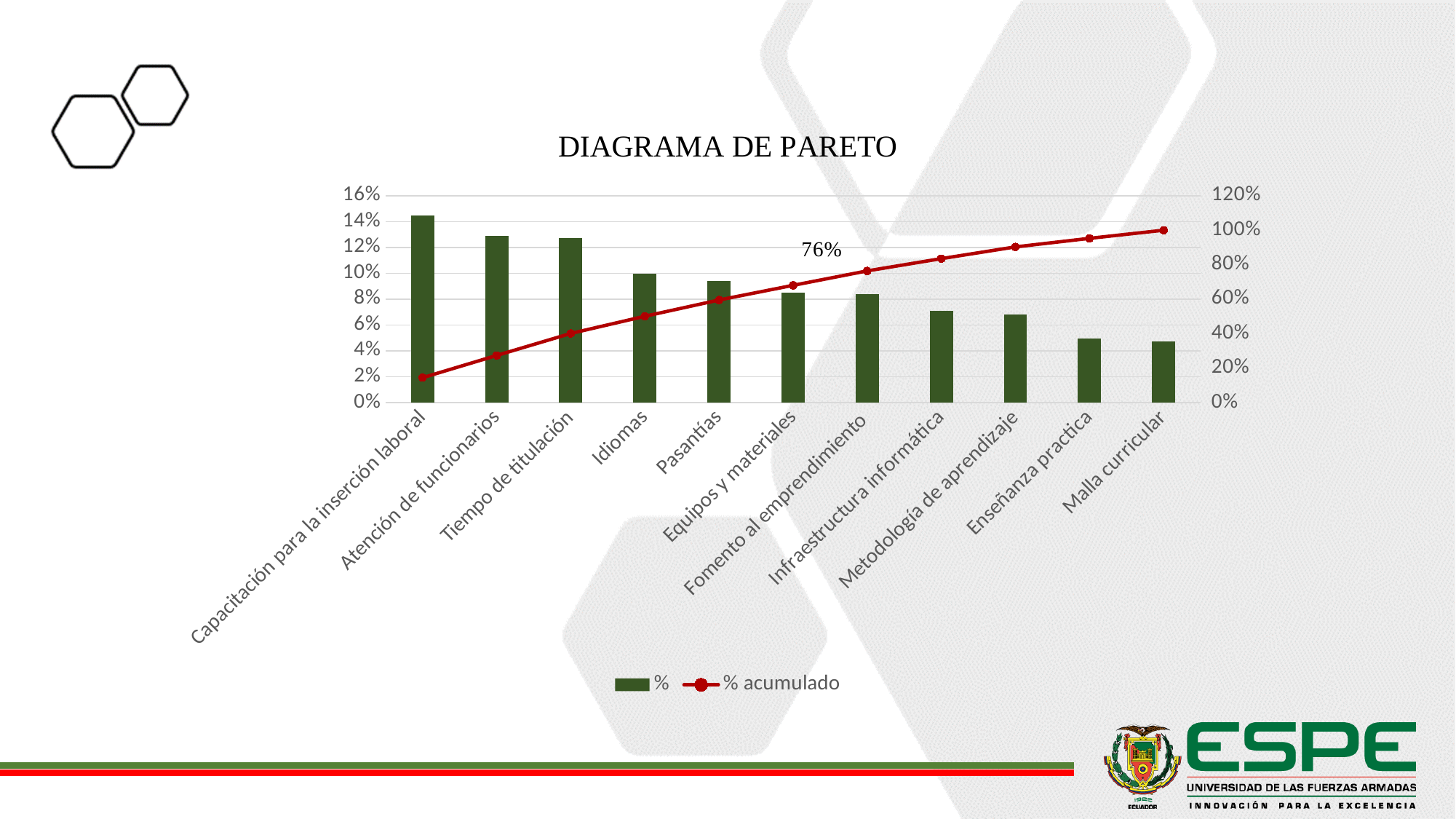
How many series does the legend list? 2 How many categories are shown on the x axis? 11 Is the bar value for Capacitación para la inserción laboral greater or less than 12%? greater What are the two series named in the legend? % and % acumulado Is the bar value for Idiomas greater or less than 8%? greater Do the bar values rise or fall from left to right along the x axis? fall What value is printed as a data label on the % acumulado line? 76% Is the bar value for Malla curricular greater or less than 6%? less Does the % acumulado line rise or fall from left to right? rise Which category has the highest bar? Capacitación para la inserción laboral What is the title of the chart? DIAGRAMA DE PARETO Which has the larger bar, Atención de funcionarios or Idiomas? Atención de funcionarios